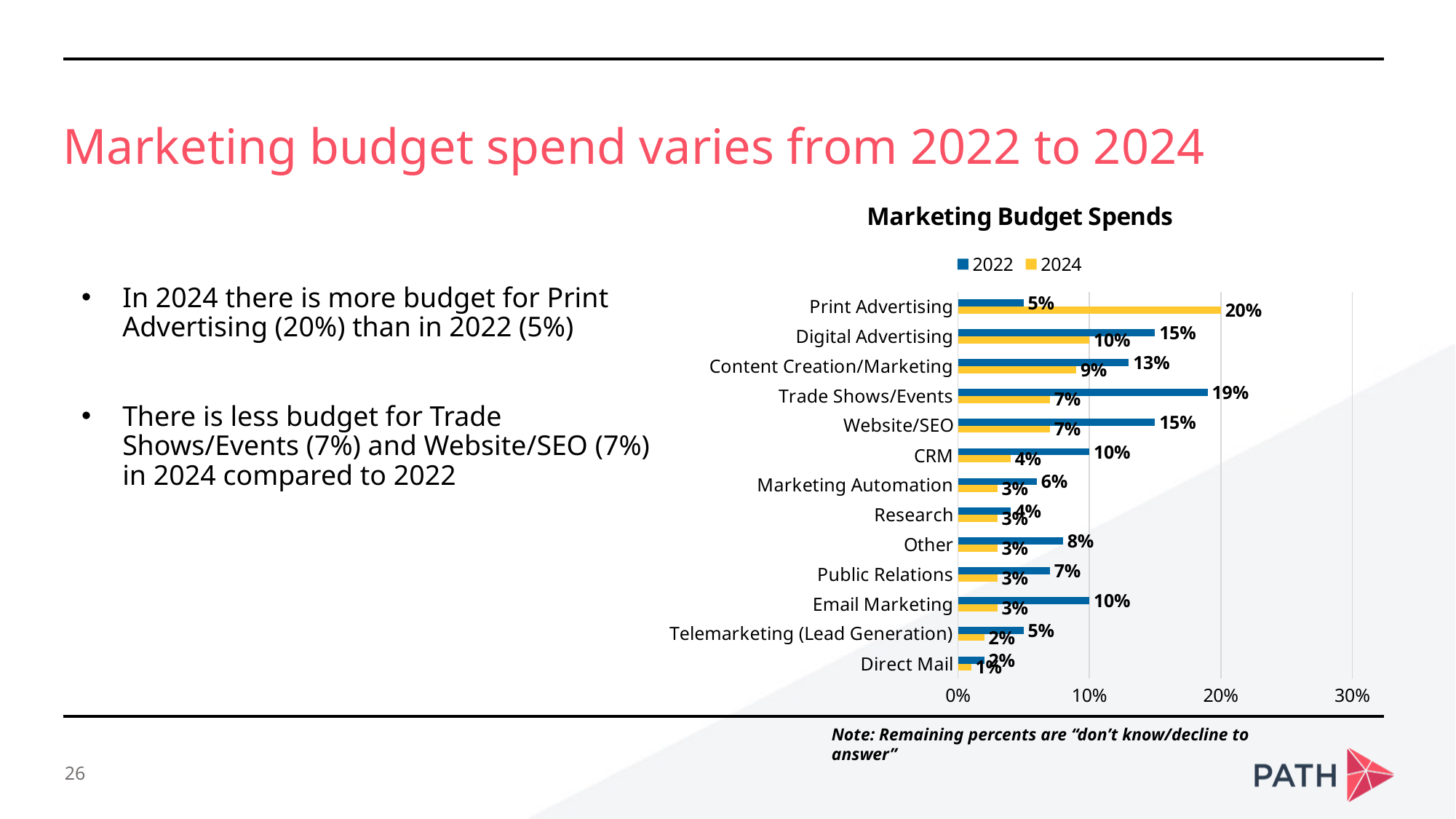
What is the difference between the 2024 and 2022 values for Print Advertising? 15% Which category has the lowest 2024 value? Direct Mail What is the difference between the 2022 and 2024 values for Website/SEO? 8% What is the 2024 value for Print Advertising? 20% How many series does the legend list? 2 Which category has the highest 2022 value? Trade Shows/Events How many categories are shown in the chart? 13 What is the 2024 value for CRM? 4% What is the 2022 value for Trade Shows/Events? 19% What is the title of the chart? Marketing Budget Spends Which is larger for Digital Advertising, the 2022 value or the 2024 value? 2022 What type of chart is shown on the slide? Bar chart